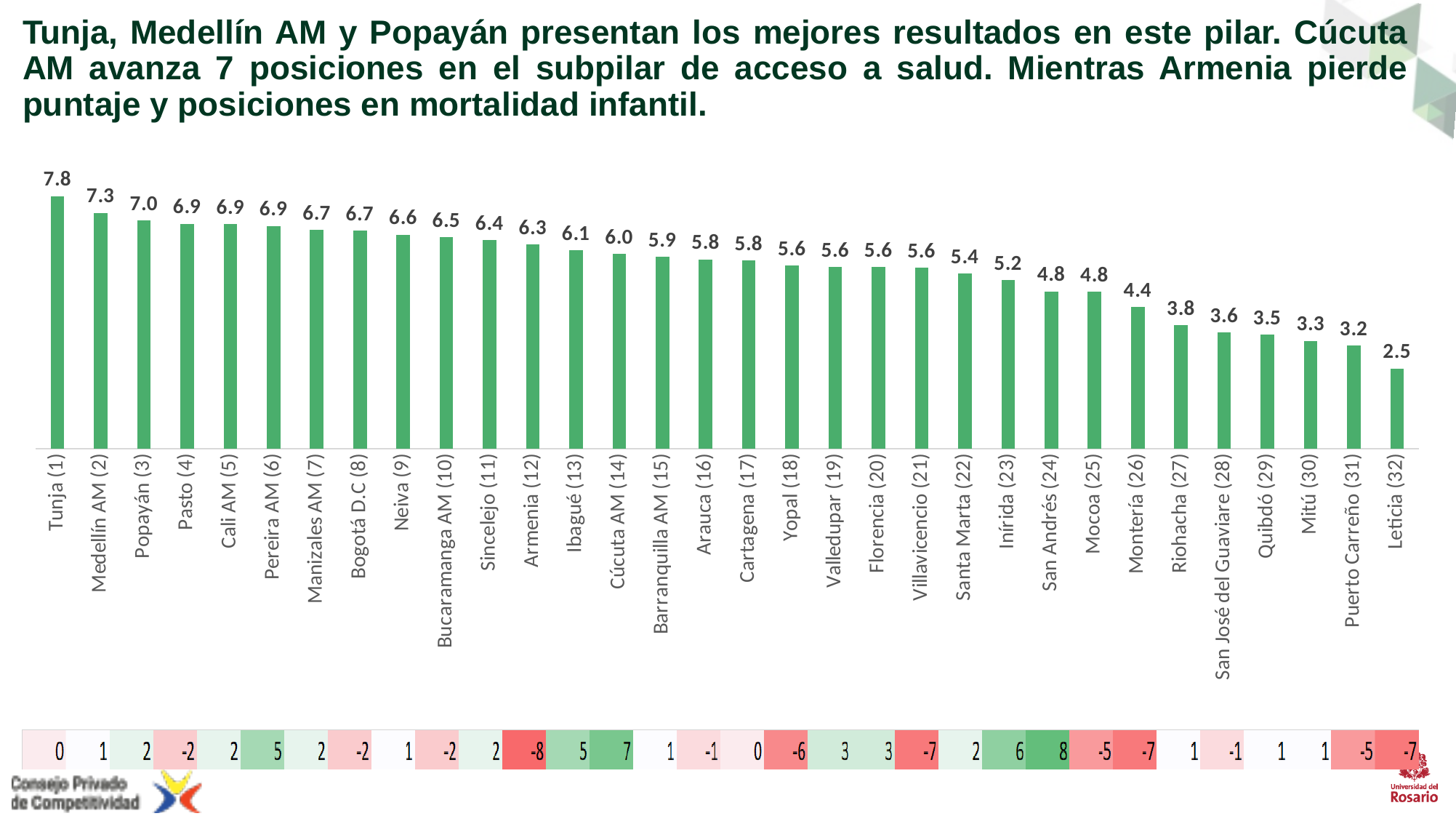
What is the value for Tunja (1)? 7.8 What kind of chart is shown on the slide? Bar chart How many cities are shown in the bar chart? 32 What is the value for Armenia (12)? 6.3 Which city has the highest value in the chart? Tunja (1) What is the difference between the values for Tunja (1) and Leticia (32)? 5.3 Which has a larger value, Bogotá D.C (8) or Riohacha (27)? Bogotá D.C (8) What is the difference between the values for Medellín AM (2) and Montería (26)? 2.9 Do the values rise or fall from left to right along the x axis? Fall What is the value for Cúcuta AM (14)? 6.0 What is the value for San José del Guaviare (28)? 3.6 Which city has the lowest value in the chart? Leticia (32)